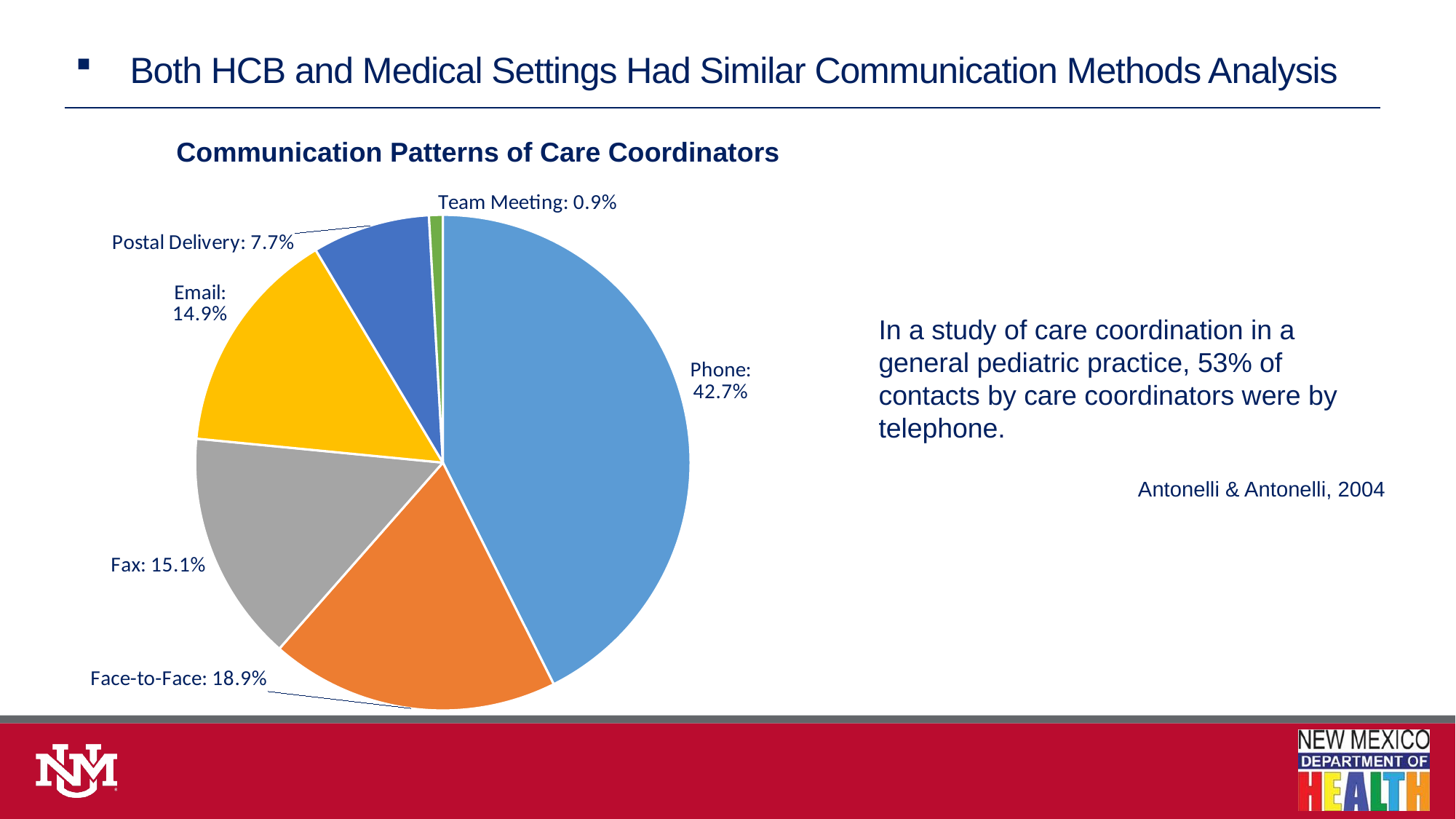
What is the title of the chart? Communication Patterns of Care Coordinators What is the value shown for Postal Delivery? 7.7% What is the value shown for Email? 14.9% How many communication methods are shown in the pie chart? 6 What kind of chart is shown on the slide? Pie chart What share of the pie does Phone account for? 42.7% What is the difference between the Phone and Face-to-Face percentages? 23.8% What is the difference between the Email and Postal Delivery percentages? 7.2% What is the value shown for Face-to-Face? 18.9% Which is larger, the Face-to-Face slice or the Email slice? Face-to-Face Which communication method has the smallest slice of the pie? Team Meeting Which communication method has the largest slice of the pie? Phone